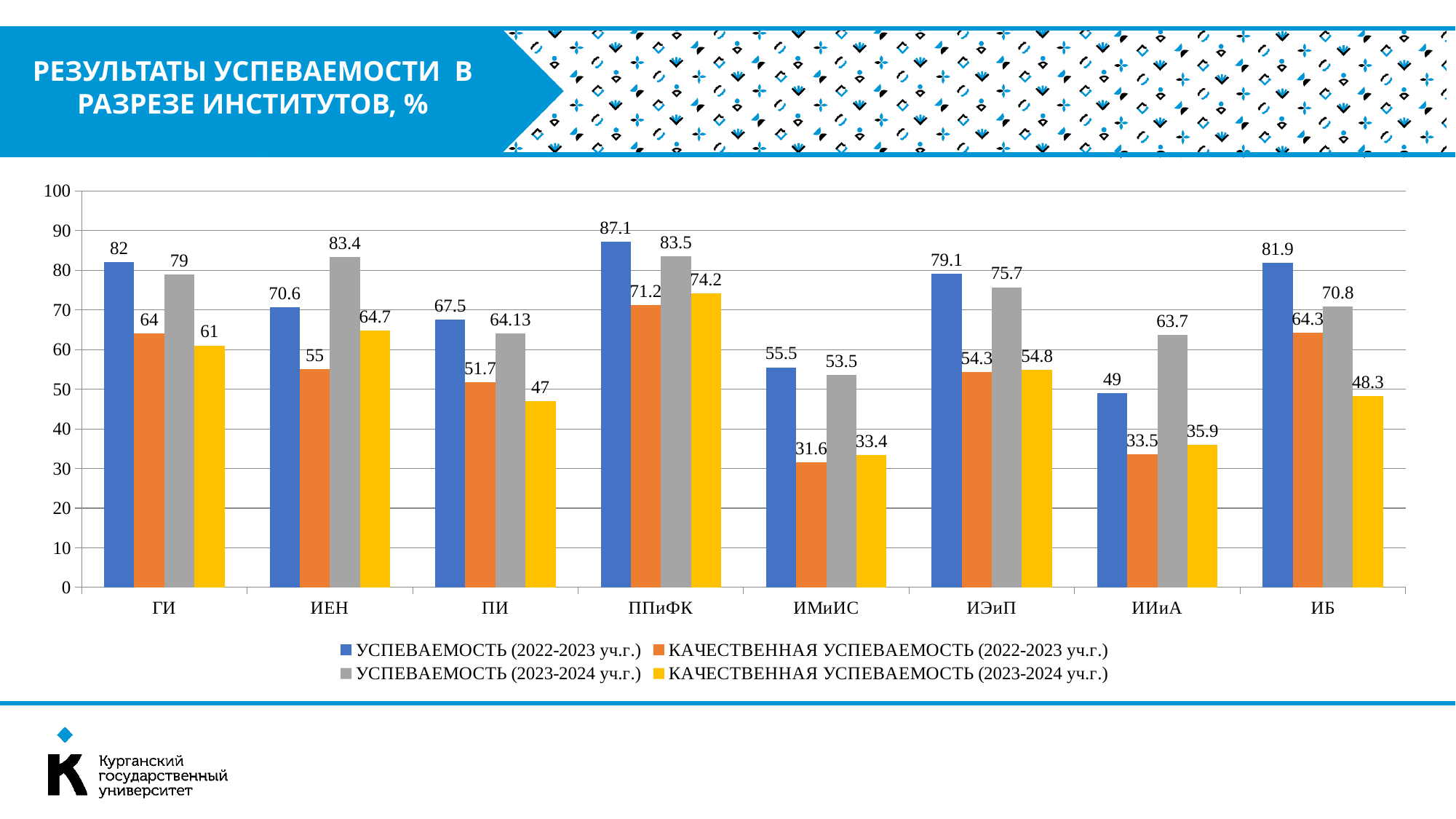
How many series does the legend list? 4 Which institute has the highest КАЧЕСТВЕННАЯ УСПЕВАЕМОСТЬ (2022-2023 уч.г.)? ППиФК What is the value of УСПЕВАЕМОСТЬ (2023-2024 уч.г.) for ПИ? 64.13 Which institute has the lowest УСПЕВАЕМОСТЬ (2022-2023 уч.г.)? ИИиА For ИБ, which is larger: УСПЕВАЕМОСТЬ (2022-2023 уч.г.) or УСПЕВАЕМОСТЬ (2023-2024 уч.г.)? УСПЕВАЕМОСТЬ (2022-2023 уч.г.) By how much did УСПЕВАЕМОСТЬ for ИИиА increase from 2022-2023 уч.г. to 2023-2024 уч.г.? 14.7 What is the difference between УСПЕВАЕМОСТЬ (2022-2023 уч.г.) and УСПЕВАЕМОСТЬ (2023-2024 уч.г.) for ГИ? 3 What is the value of УСПЕВАЕМОСТЬ (2022-2023 уч.г.) for ППиФК? 87.1 What kind of chart is shown on the slide? Bar chart What is the value of КАЧЕСТВЕННАЯ УСПЕВАЕМОСТЬ (2023-2024 уч.г.) for ИИиА? 35.9 What is the title of the slide? РЕЗУЛЬТАТЫ УСПЕВАЕМОСТИ В РАЗРЕЗЕ ИНСТИТУТОВ, % How many institutes are shown on the x axis of the chart? 8